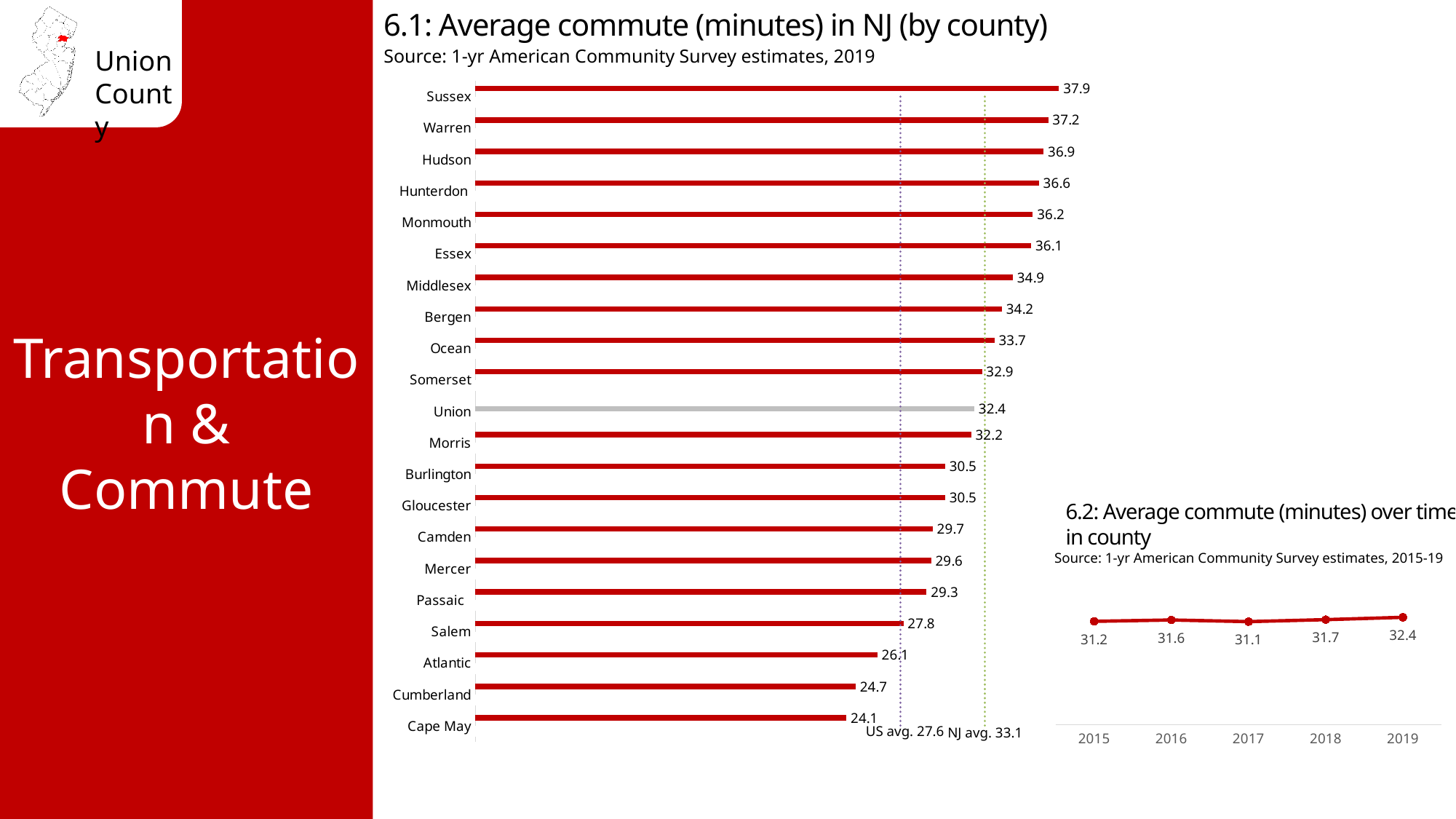
In chart 6.2 (Average commute over time in county), which year has the highest average commute? 2019 In chart 6.1 (Average commute in NJ by county), which county has the highest average commute? Sussex In chart 6.1 (Average commute in NJ by county), which county has the lowest average commute? Cape May In chart 6.2 (Average commute over time in county), what is the difference between the 2019 and 2015 values? 1.2 In chart 6.1 (Average commute in NJ by county), what is the average commute for Atlantic county? 26.1 In chart 6.1 (Average commute in NJ by county), what is the difference between the average commute for Sussex and Cape May? 13.8 In chart 6.2 (Average commute over time in county), what was the average commute in 2017? 31.1 What kind of chart is chart 6.1 (Average commute in NJ by county)? Bar chart In chart 6.1 (Average commute in NJ by county), what is the average commute for Union county? 32.4 In chart 6.1 (Average commute in NJ by county), which county has a longer average commute, Hudson or Bergen? Hudson In chart 6.1 (Average commute in NJ by county), how many counties are shown? 21 In chart 6.1 (Average commute in NJ by county), what NJ average value is marked by the dotted reference line? 33.1